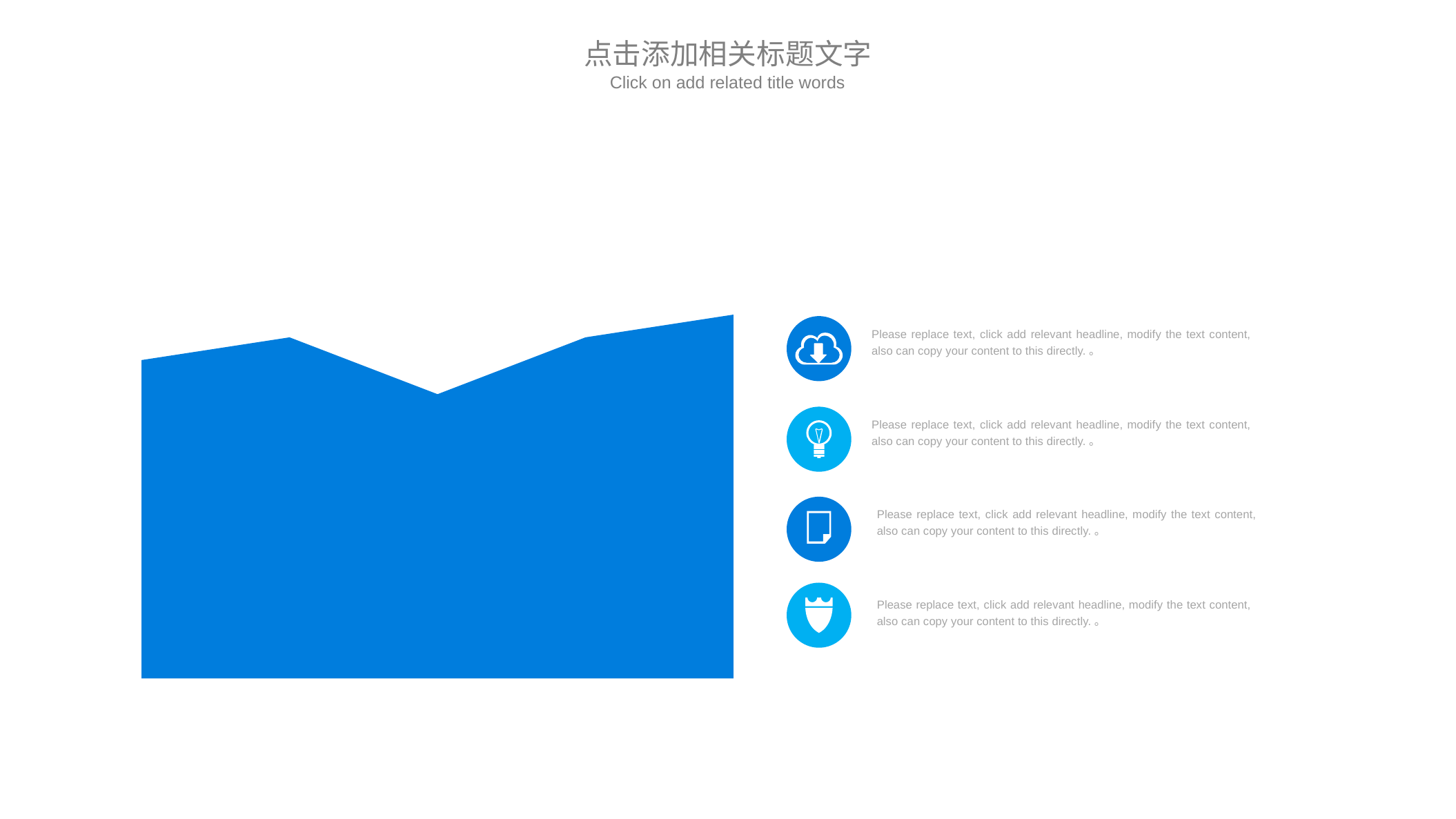
Does the area chart on the left show a legend? No How many data points does the area chart on the left plot? 5 In the area chart on the left, which data point is the highest: the first, the middle, or the last? the last In the area chart on the left, which data point is the lowest: the first, the middle, or the last? the middle What kind of chart is shown on the left of the slide? area chart In the area chart on the left, is the last data point higher or lower than the first data point? higher In the area chart on the left, do the values rise or fall from the middle point to the last point? rise What colour is the filled area in the chart on the left? blue In the area chart on the left, is the middle data point higher or lower than the second data point? lower